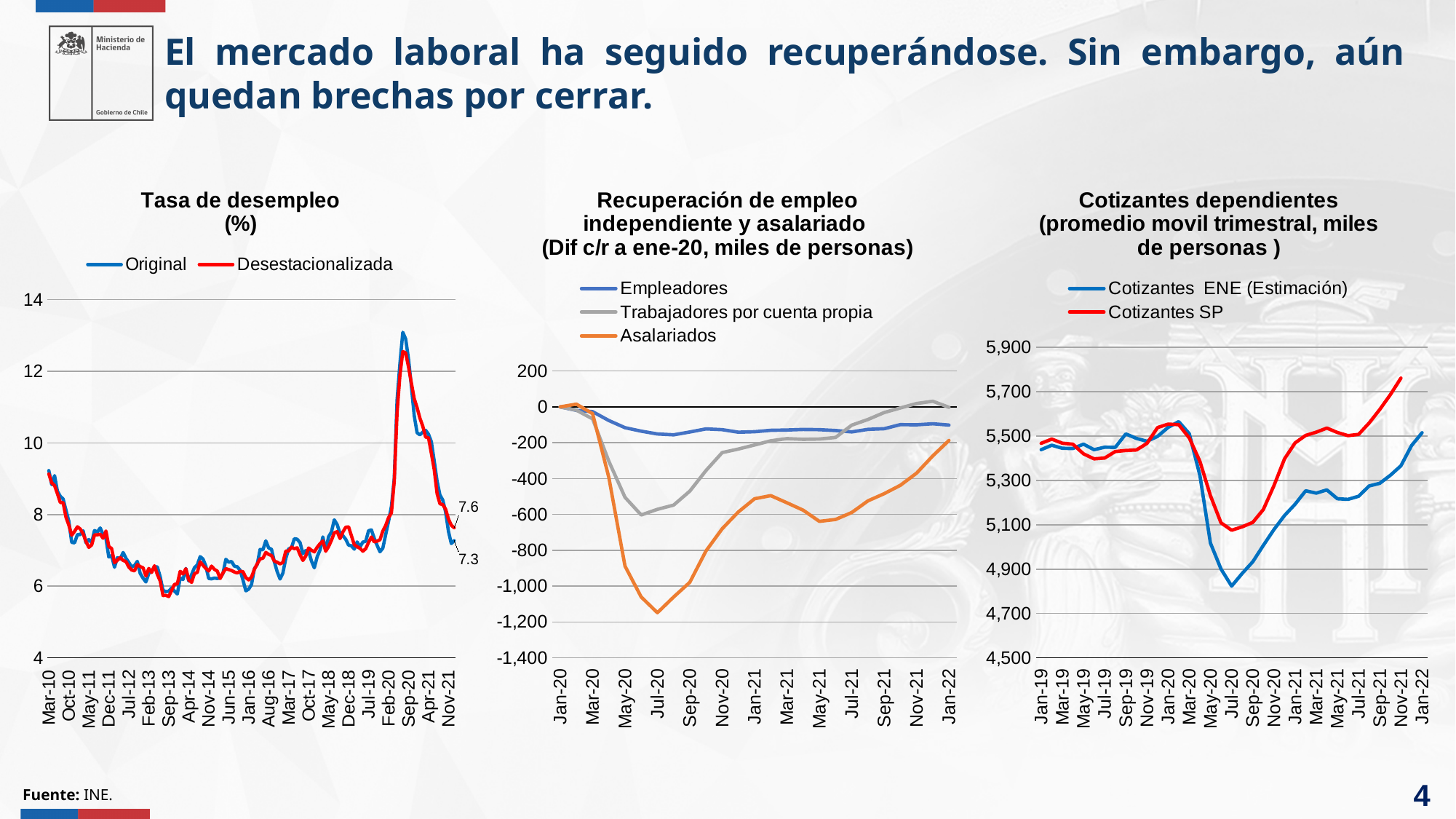
In the 'Cotizantes dependientes' chart, which series is higher at Jul-20, Cotizantes SP or Cotizantes ENE (Estimación)? Cotizantes SP What kind of chart is the 'Tasa de desempleo (%)' chart? line chart In the 'Cotizantes dependientes' chart, is the value for Cotizantes ENE (Estimación) at Jul-20 greater or less than 4,900? less In the 'Recuperación de empleo independiente y asalariado' chart, which series is shown in orange? Asalariados How many series does the legend of the 'Recuperación de empleo independiente y asalariado' chart list? 3 In the 'Recuperación de empleo independiente y asalariado' chart, is the value for Asalariados at Jul-20 greater or less than -1,000? less In the 'Recuperación de empleo independiente y asalariado' chart, is the value for Trabajadores por cuenta propia at May-20 greater or less than -400? less In the 'Recuperación de empleo independiente y asalariado' chart, which series reaches the lowest value? Asalariados In the 'Tasa de desempleo (%)' chart, what are the two data labels printed at the end of the series? 7.6 and 7.3 In the 'Recuperación de empleo independiente y asalariado' chart, do the values for Asalariados rise or fall between Jan-20 and Jul-20? fall